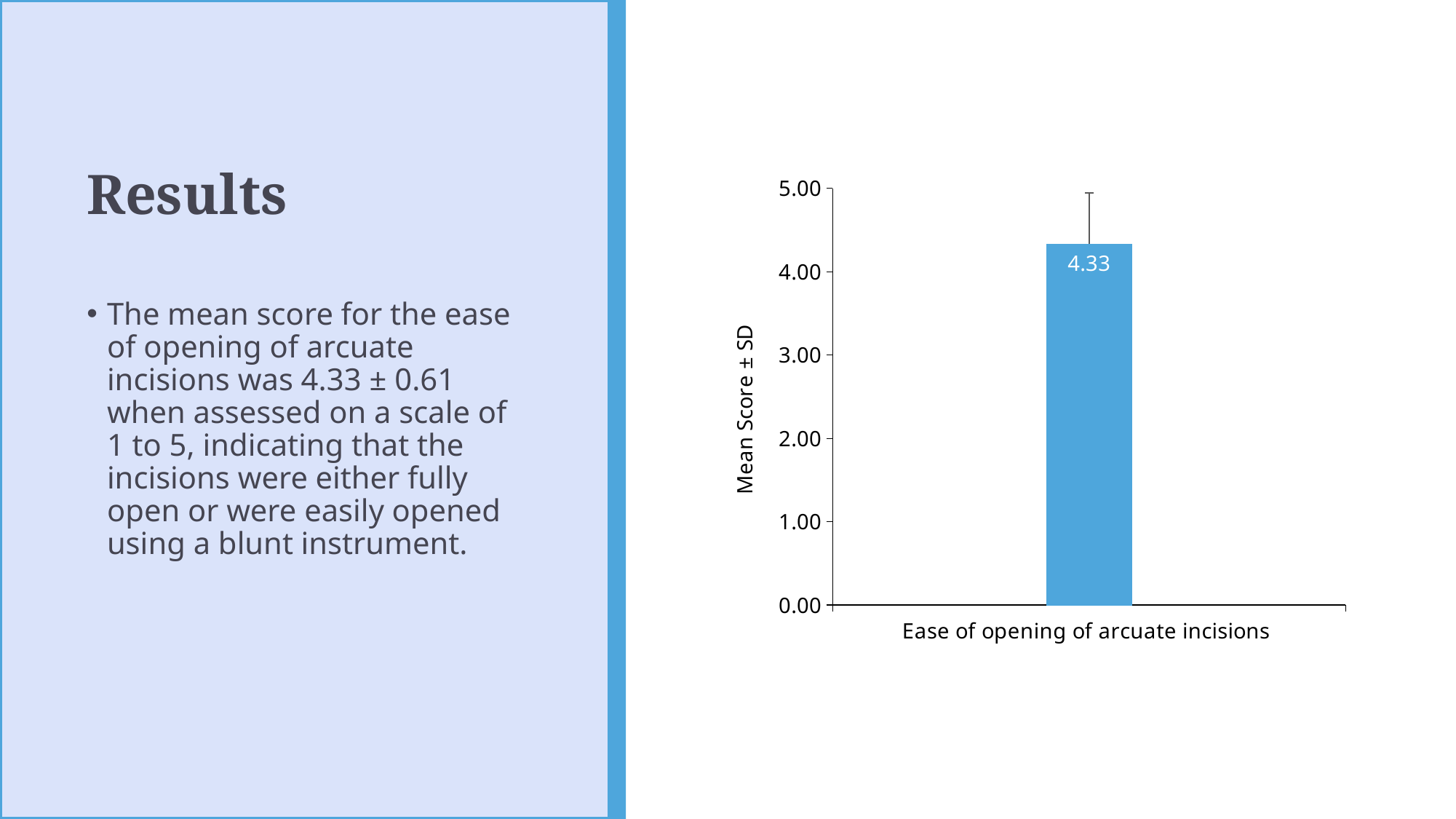
Is the value for Ease of opening of arcuate incisions greater or less than 5.00? less What is the category label on the horizontal axis of the chart? Ease of opening of arcuate incisions Is the value for Ease of opening of arcuate incisions greater or less than 4.00? greater What kind of chart is shown on the slide? bar chart What is the label on the vertical axis of the chart? Mean Score ± SD What is the maximum value shown on the vertical axis of the chart? 5.00 How many bars does the chart show? 1 What is the value shown for Ease of opening of arcuate incisions? 4.33